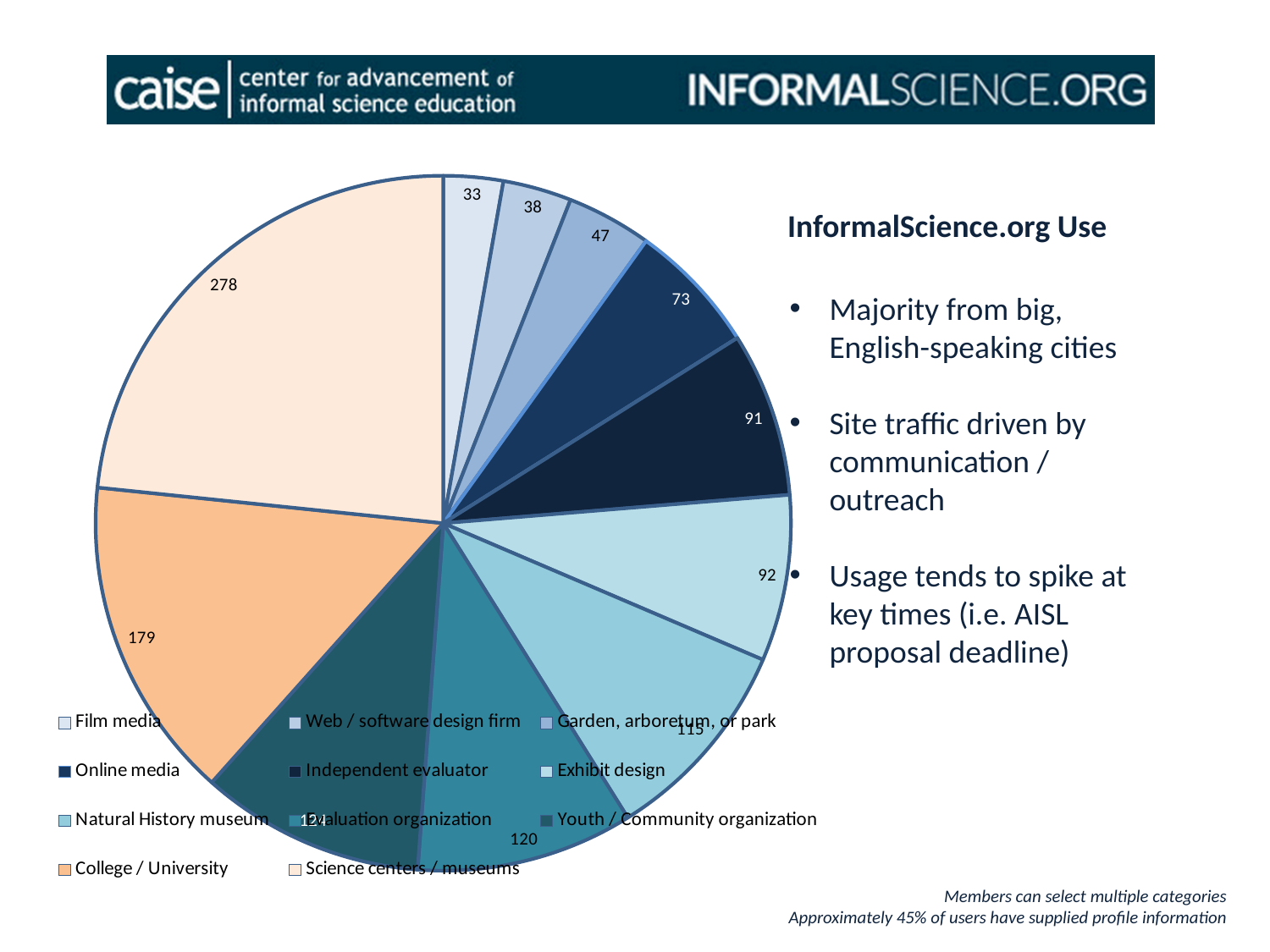
How many categories does the legend of the pie chart list? 11 What is the value shown for Independent evaluator? 91 What is the difference between the values for Science centers / museums and College / University? 99 What is the value shown for College / University? 179 What kind of chart is shown on the slide? pie chart What is the value shown for Web / software design firm? 38 Which is larger, the value for Online media or the value for Garden, arboretum, or park? Online media What is the value shown for Science centers / museums? 278 What is the value shown for Online media? 73 What is the difference between the values for Independent evaluator and Online media? 18 Which category has the largest slice of the pie? Science centers / museums Which category has the smallest slice of the pie? Film media